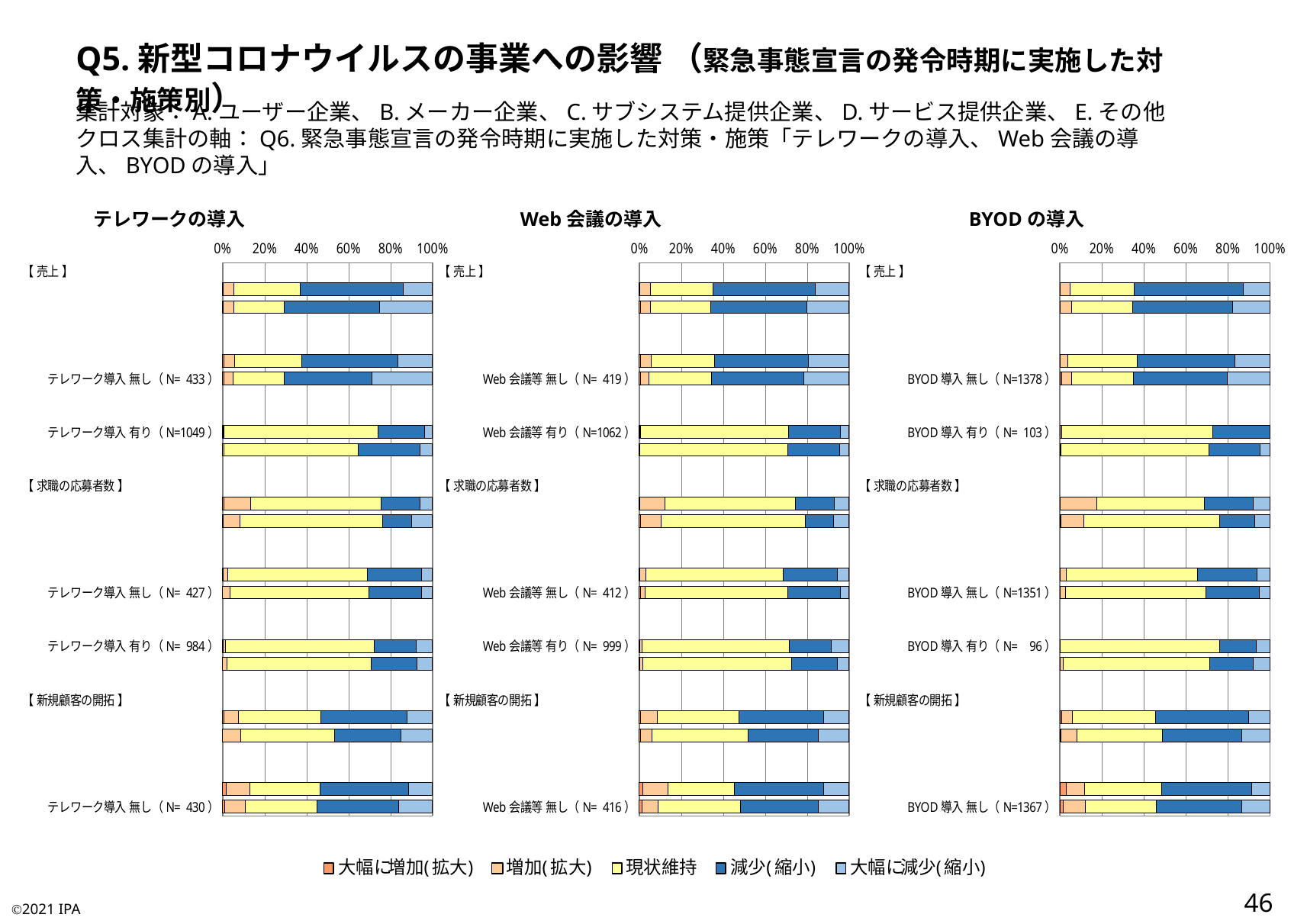
In the Web 会議の導入 chart, what is the N value shown for Web 会議等 有り in the 【売上】 section? 1062 In the Web 会議の導入 chart, is the 現状維持 share for Web 会議等 無し (N= 419) in the 【売上】 section greater or less than 60%? less How many series does the legend list? 5 Which legend entry is shown in yellow? 現状維持 What is the title of the chart on the right of the slide? BYOD の導入 What is the maximum value shown on the x axis of the Web 会議の導入 chart? 100% In the BYOD の導入 chart, is the 現状維持 share for BYOD 導入 有り (N= 103) in the 【売上】 section greater or less than 60%? greater How many charts are shown on the slide? 3 In the BYOD の導入 chart, what is the N value shown for BYOD 導入 有り in the 【求職の応募者数】 section? 96 What kind of chart is used for テレワークの導入? stacked bar chart In the テレワークの導入 chart, is the 現状維持 share for テレワーク導入 有り (N=1049) in the 【売上】 section greater or less than 60%? greater In the テレワークの導入 chart, what is the N value shown for テレワーク導入 無し in the 【売上】 section? 433